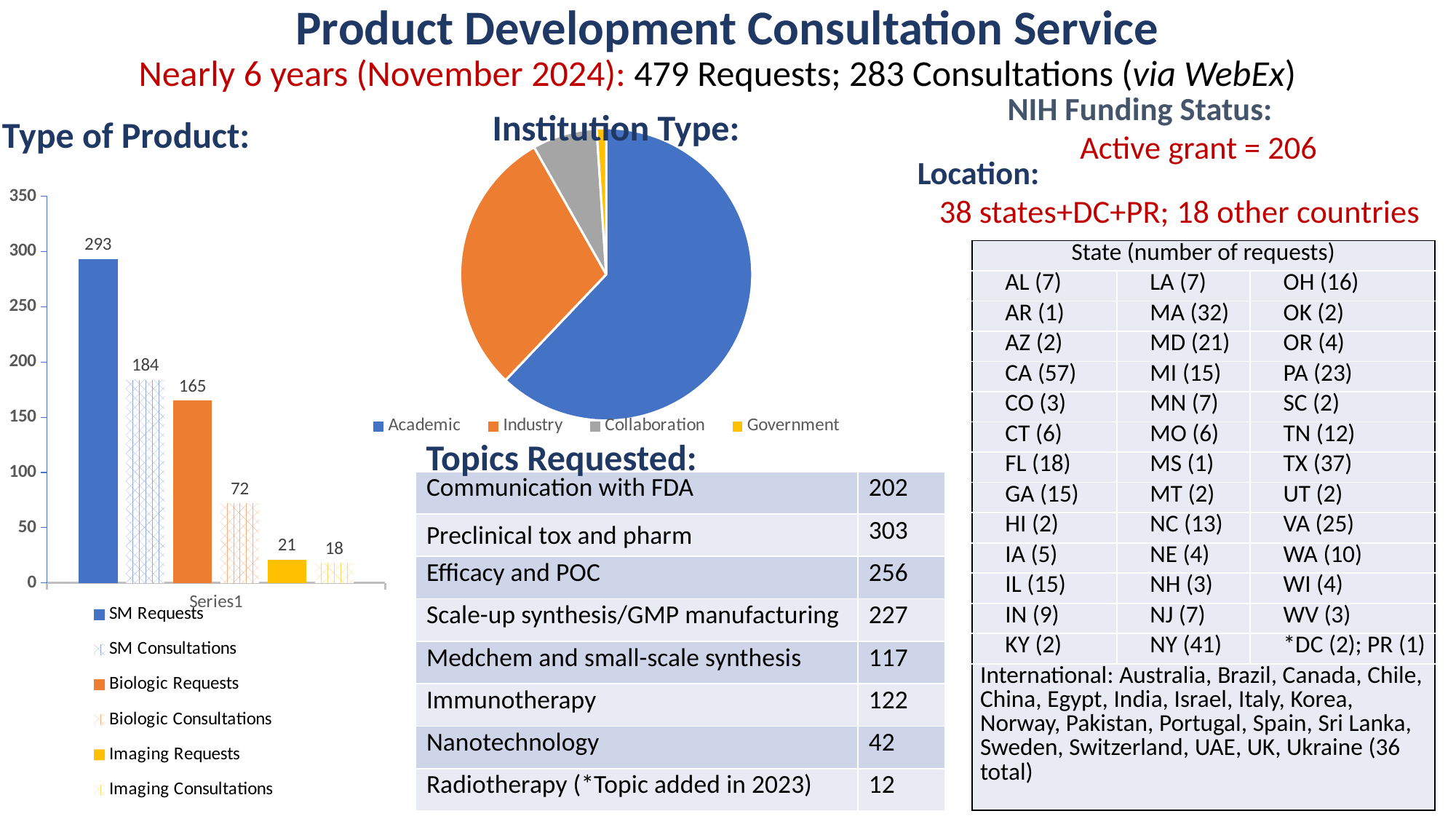
What kind of chart is the Type of Product chart? Bar chart In the Institution Type pie chart, which institution type has the smallest slice? Government How many series does the legend of the Type of Product bar chart list? 6 In the Type of Product bar chart, which is larger: SM Consultations or Biologic Requests? SM Consultations In the Type of Product bar chart, what is the value for Imaging Consultations? 18 In the Institution Type pie chart, which institution type has the largest slice? Academic In the Type of Product bar chart, what is the value for Biologic Consultations? 72 In the Type of Product bar chart, what is the difference between SM Requests and SM Consultations? 109 In the Type of Product bar chart, which series has the lowest value? Imaging Consultations In the Type of Product bar chart, what is the value for SM Requests? 293 In the Type of Product bar chart, which series has the highest value? SM Requests In the Type of Product bar chart, what is the difference between Biologic Requests and Biologic Consultations? 93